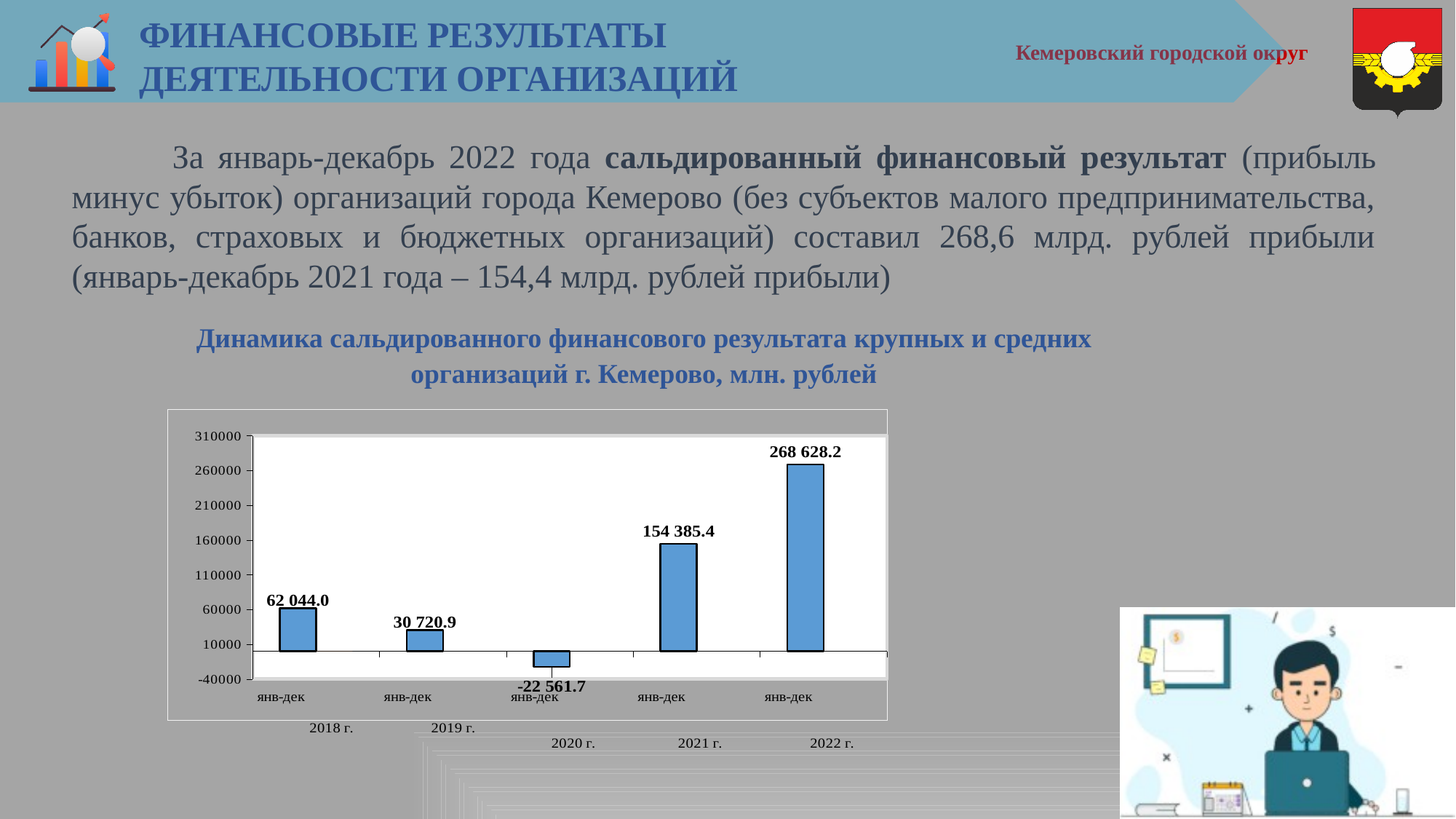
Which is larger, the value for 2018 or the value for 2019? 2018 What is the value for 2020 (янв-дек) in the chart? -22 561.7 Which year has the lowest value in the chart? 2020 г. Which year has the highest value in the chart? 2022 г. What type of chart is shown on the slide? bar chart In what units are the values in the chart expressed, according to its title? млн. рублей What is the difference between the values for 2022 and 2021? 114 242.8 What is the difference between the values for 2018 and 2019? 31 323.1 What is the value for 2022 (янв-дек) in the chart? 268 628.2 How many bars (years) are shown in the chart? 5 What is the value for 2019 (янв-дек) in the chart? 30 720.9 What is the value for 2018 (янв-дек) in the chart? 62 044.0